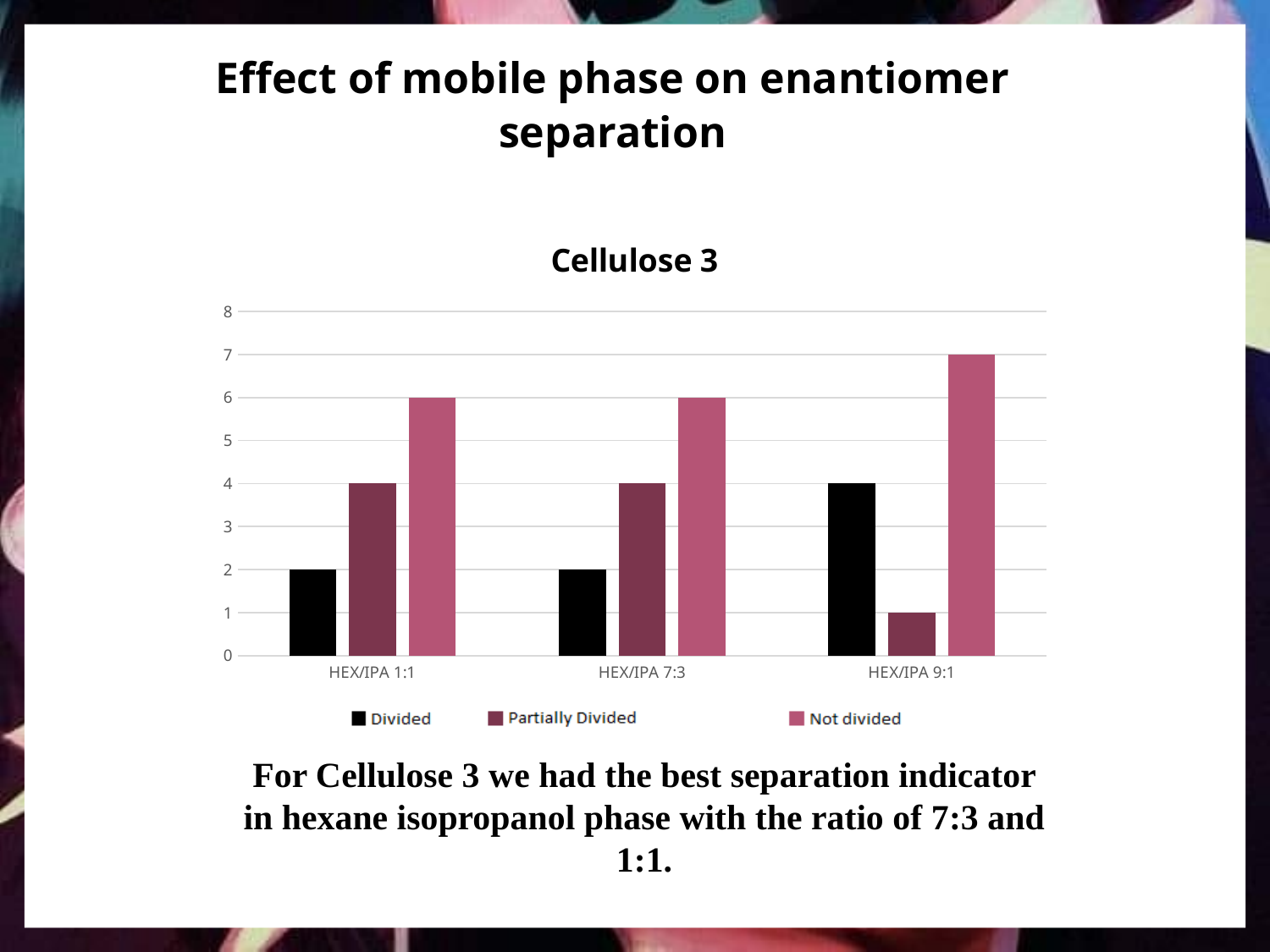
How many series does the legend list? 3 How many mobile phase categories are shown on the x axis? 3 What kind of chart is shown on the slide? Bar chart What is the value for Divided at HEX/IPA 1:1? 2 What is the difference between the Not divided and Divided values at HEX/IPA 1:1? 4 What is the value for Not divided at HEX/IPA 7:3? 6 Which is larger at HEX/IPA 9:1, Divided or Partially Divided? Divided For which mobile phase is the Partially Divided value lowest? HEX/IPA 9:1 What is the value for Partially Divided at HEX/IPA 9:1? 1 For which mobile phase is the Not divided value highest? HEX/IPA 9:1 What is the value for Not divided at HEX/IPA 9:1? 7 What is the title of the chart? Cellulose 3